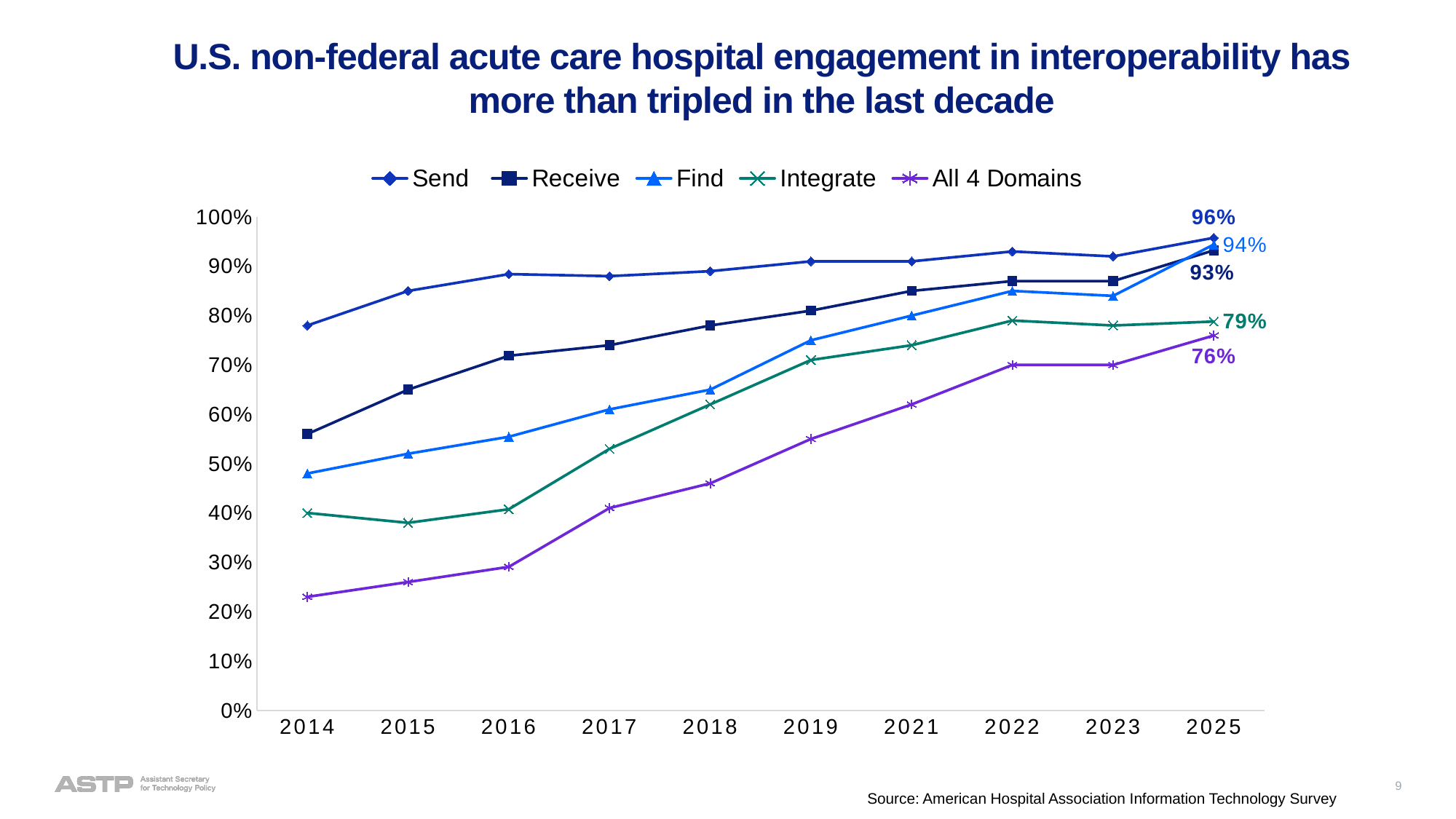
What is the value for All 4 Domains in 2025? 76% What is the value for Send in 2025? 96% What is the value for Integrate in 2025? 79% What is the difference between the Receive and Integrate values in 2025? 14% How many series does the legend list? 5 What kind of chart is shown on the slide? line chart Which series has the highest value in 2025? Send What is the value for Find in 2025? 94% How many years are shown on the x axis? 10 Does the All 4 Domains series rise or fall from 2014 to 2025? rise Which series has the lowest value in 2025? All 4 Domains Is the value for All 4 Domains in 2014 greater or less than 30%? less